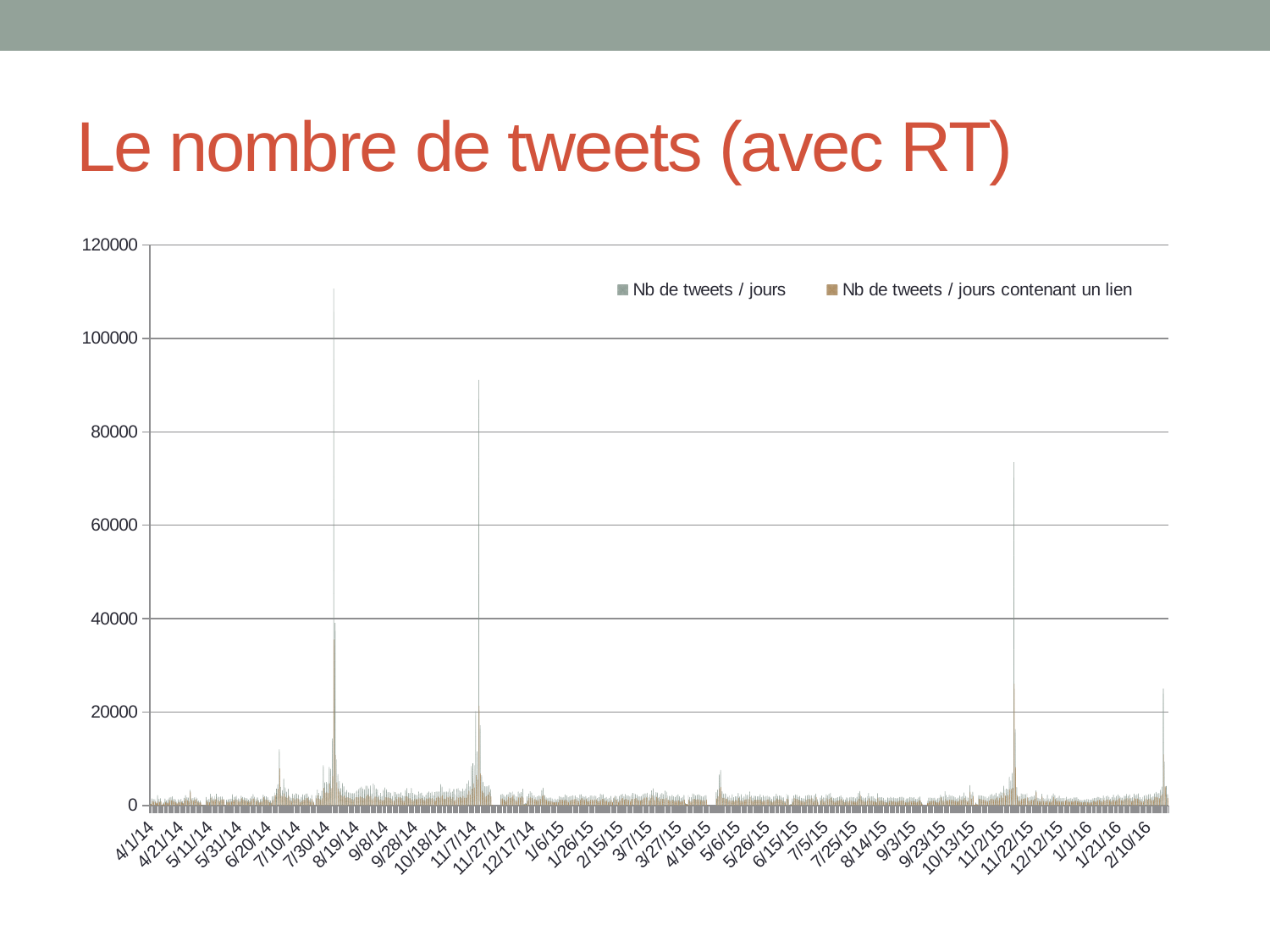
Is the tallest spike in late November 2014 (near 11/27/14) greater or less than 80000? greater What is the highest value shown on the vertical axis? 120000 Is the spike at the far right of the chart (near 2/10/16) greater or less than 20000? greater What is the title of the slide's chart? Le nombre de tweets (avec RT) Which is larger: the tallest spike in August 2014 or the tallest spike in November 2015? the tallest spike in August 2014 Is the tallest spike in November 2015 (near 11/22/15) greater or less than 60000? greater Which series reaches the highest values on the chart? Nb de tweets / jours How many series does the legend list? 2 What are the two series named in the legend? Nb de tweets / jours; Nb de tweets / jours contenant un lien What kind of chart is shown on the slide? bar chart